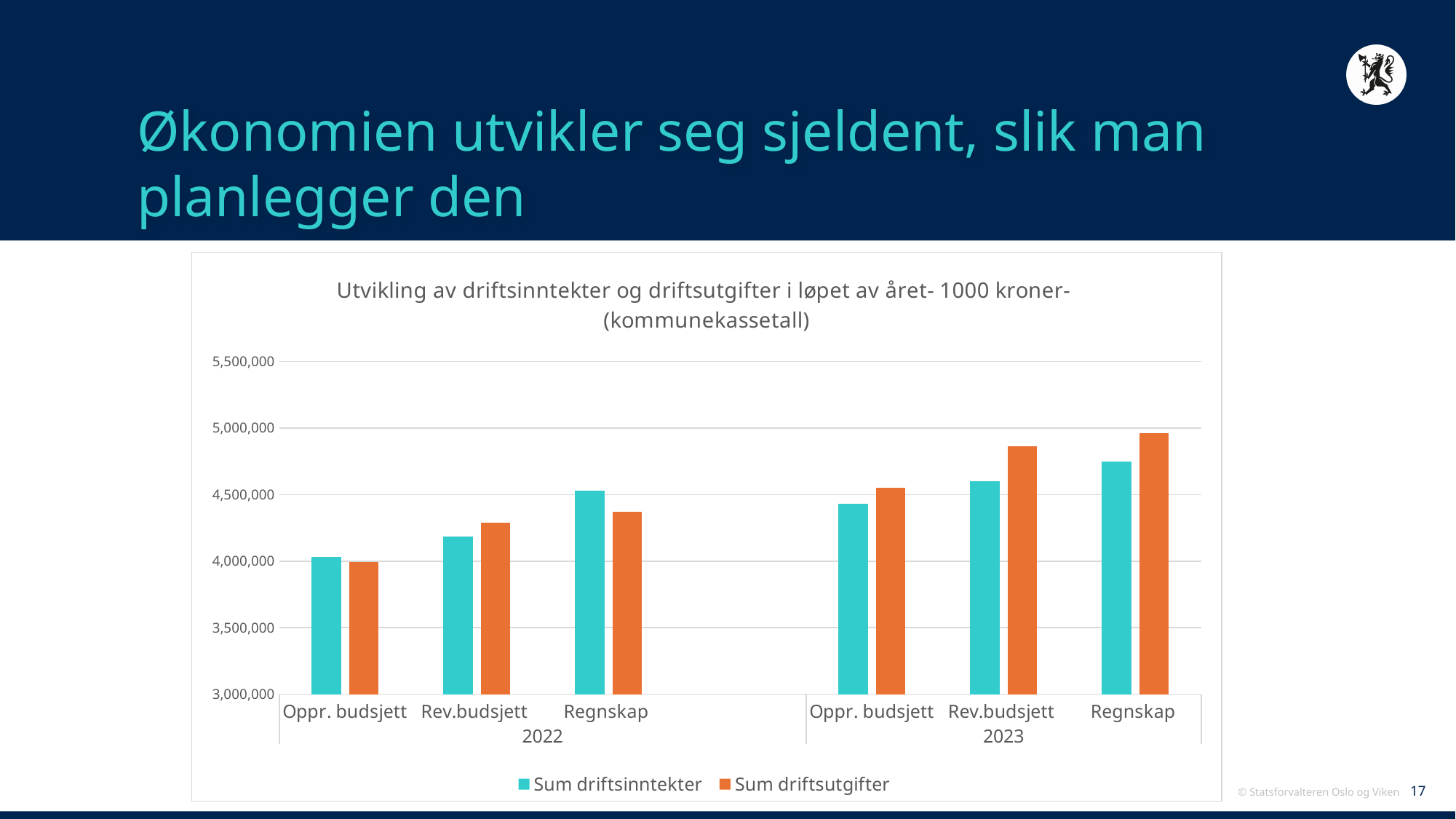
How many series does the legend list? 2 Within 2023, do the Sum driftsutgifter values rise or fall from Oppr. budsjett to Regnskap? Rise Is the value for Sum driftsutgifter at Rev.budsjett 2022 greater or less than 4,500,000? less For Regnskap 2022, which is larger: Sum driftsinntekter or Sum driftsutgifter? Sum driftsinntekter Is the value for Sum driftsinntekter at Rev.budsjett 2022 greater or less than 4,000,000? greater How many category groups (bar pairs) are plotted along the x axis? 6 What type of chart is shown on the slide? Bar chart Is the value for Sum driftsinntekter at Oppr. budsjett 2023 greater or less than 4,500,000? less For Rev.budsjett 2023, which is larger: Sum driftsinntekter or Sum driftsutgifter? Sum driftsutgifter Which category has the highest value for Sum driftsutgifter? Regnskap 2023 Which category has the lowest value for Sum driftsinntekter? Oppr. budsjett 2022